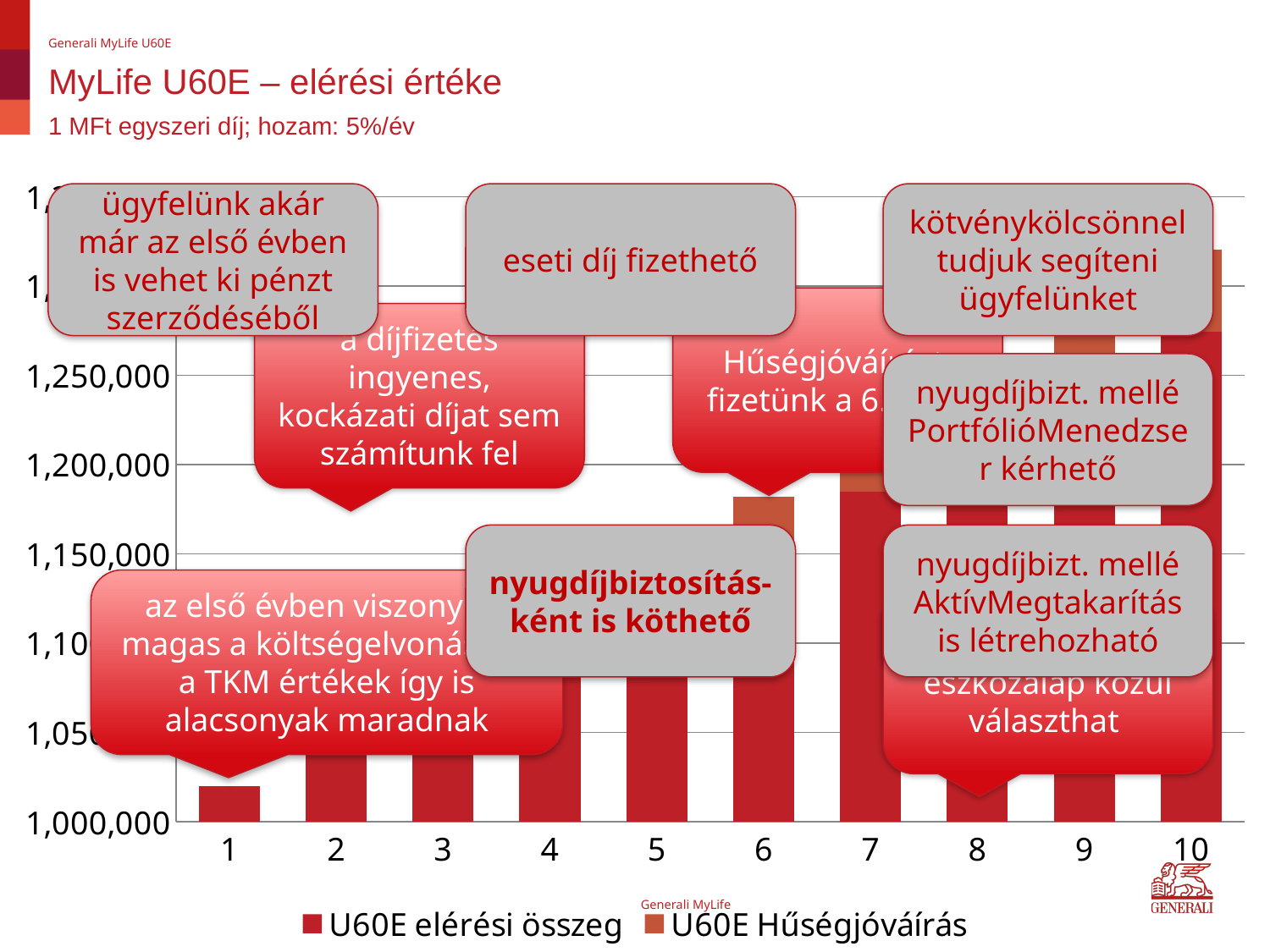
What kind of chart is shown on the slide? bar chart What are the two series named in the legend? U60E elérési összeg; U60E Hűségjóváírás Do the bar values rise or fall from category 1 to category 10? rise Which category has the lowest bar? 1 Which category has the highest bar? 10 Is the total value for category 10 greater or less than 1,250,000? greater How many series does the legend list? 2 How many categories are shown on the x axis? 10 Is the total value for category 6 greater or less than 1,150,000? greater Is the value for category 1 greater or less than 1,050,000? less Which is larger, the bar for category 1 or the bar for category 6? category 6 What is the title of the chart on the slide? MyLife U60E – elérési értéke